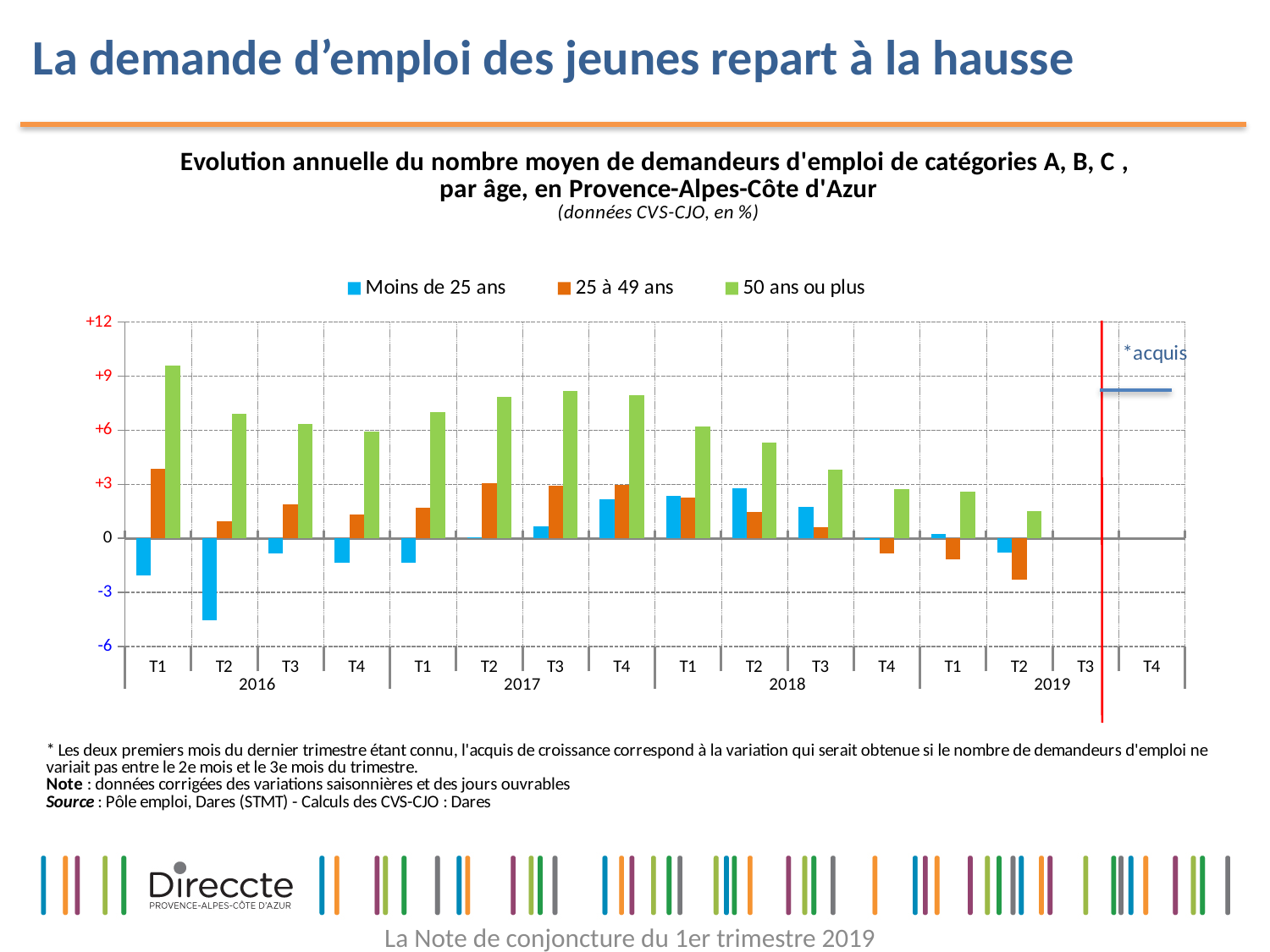
In which quarter does Moins de 25 ans reach its lowest value? T2 2016 Is the value for 50 ans ou plus in T1 2016 greater or less than +9? greater How many quarters have bars plotted in the chart? 14 In T2 2019, which is lower: Moins de 25 ans or 25 à 49 ans? 25 à 49 ans In T2 2018, which is larger: Moins de 25 ans or 25 à 49 ans? Moins de 25 ans Is the value for 50 ans ou plus in T2 2019 greater or less than +3? less Does the value for 50 ans ou plus rise or fall from T3 2017 to T2 2019? Falls What type of chart is shown on the slide? Bar chart How many series does the legend list? 3 Which age group has the highest value in T1 2016? 50 ans ou plus Which age groups are listed in the legend? Moins de 25 ans, 25 à 49 ans, 50 ans ou plus Is the value for Moins de 25 ans in T2 2016 greater or less than -3? less